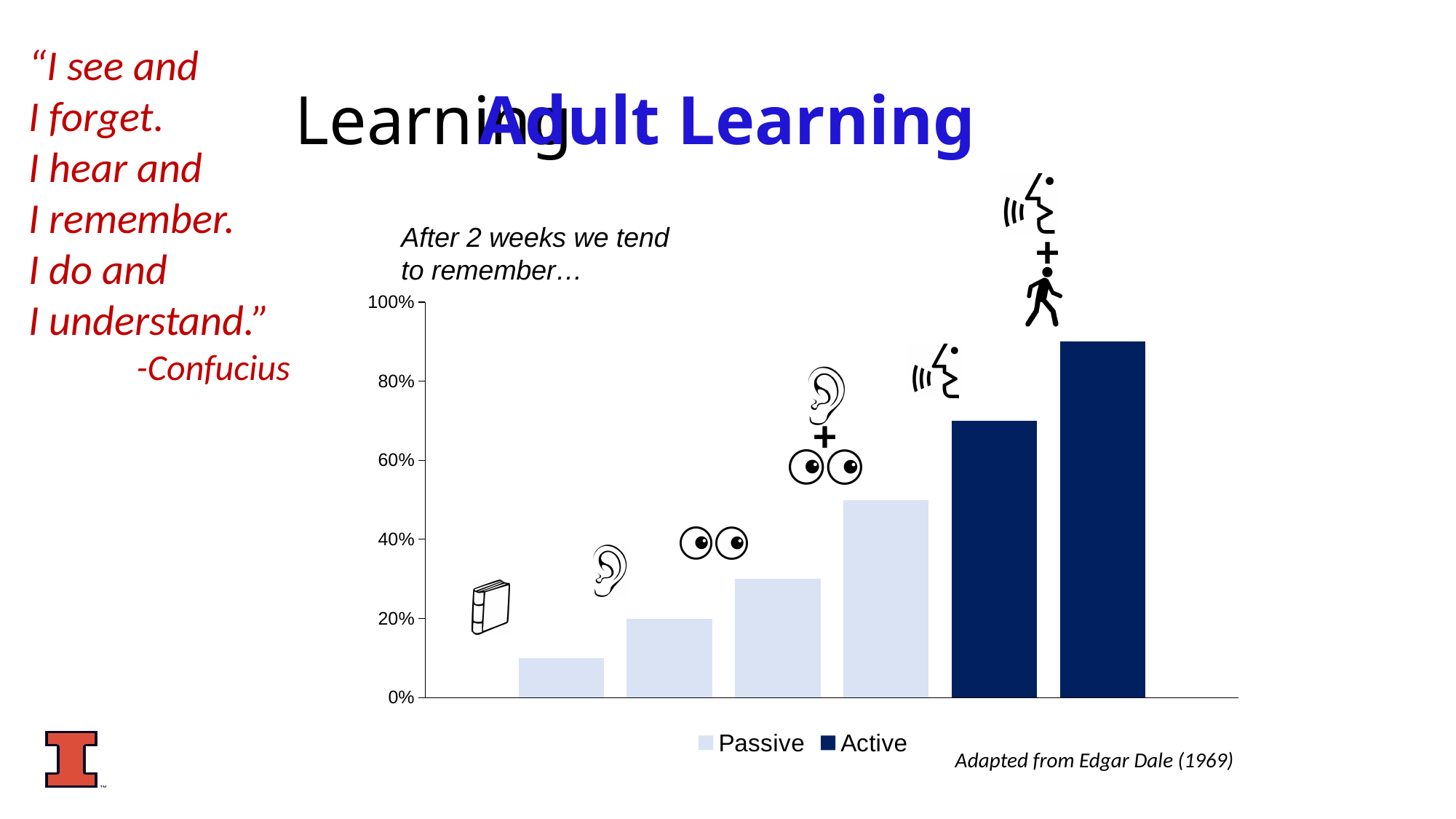
Is the value of the third bar from the left greater or less than 40%? less What kind of chart is shown on the slide? bar chart What value does the second bar from the left reach on the y axis? 20% Is the value of the rightmost bar greater or less than 80%? greater Do the bar values rise or fall from left to right across the chart? rise Which bar is the tallest in the chart? the rightmost bar Is the value of the fourth bar from the left greater or less than 40%? greater What are the two series named in the chart's legend? Passive and Active How many series does the chart's legend list? 2 How many bars are plotted in the chart? 6 Which bar is the shortest in the chart? the leftmost bar